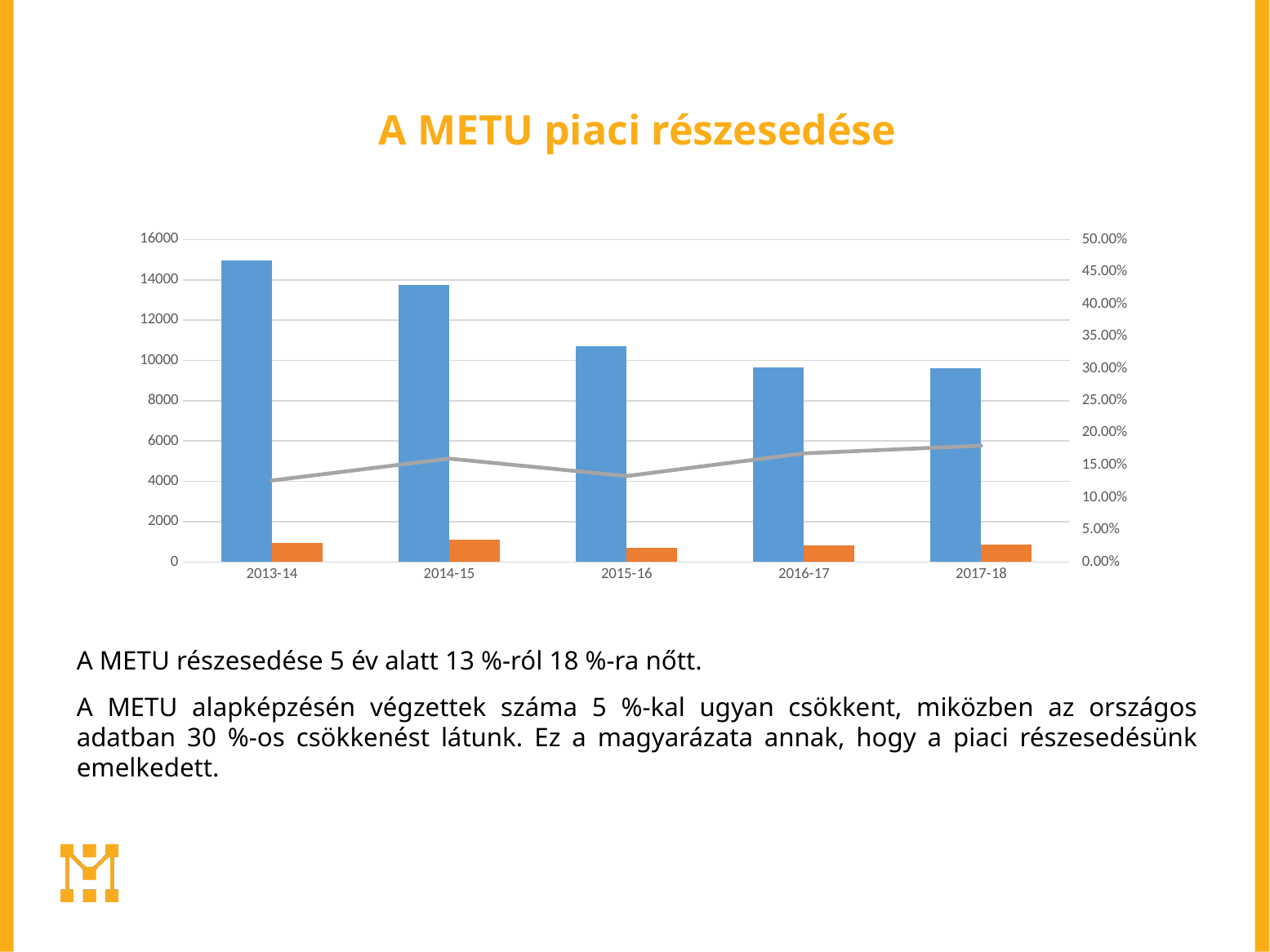
Is the blue bar for 2015-16 greater or less than 10000? greater Is the gray line value for 2013-14 greater or less than 15.00% on the right axis? less Do the blue bars rise or fall from 2013-14 to 2017-18? fall What kind of chart is this? Bar chart with a line Is the orange bar for 2014-15 greater or less than 2000? less Which year has the shortest orange bar? 2015-16 What is the title of the chart? A METU piaci részesedése Which year has the tallest blue bar? 2013-14 How many categories (academic years) are shown on the x axis? 5